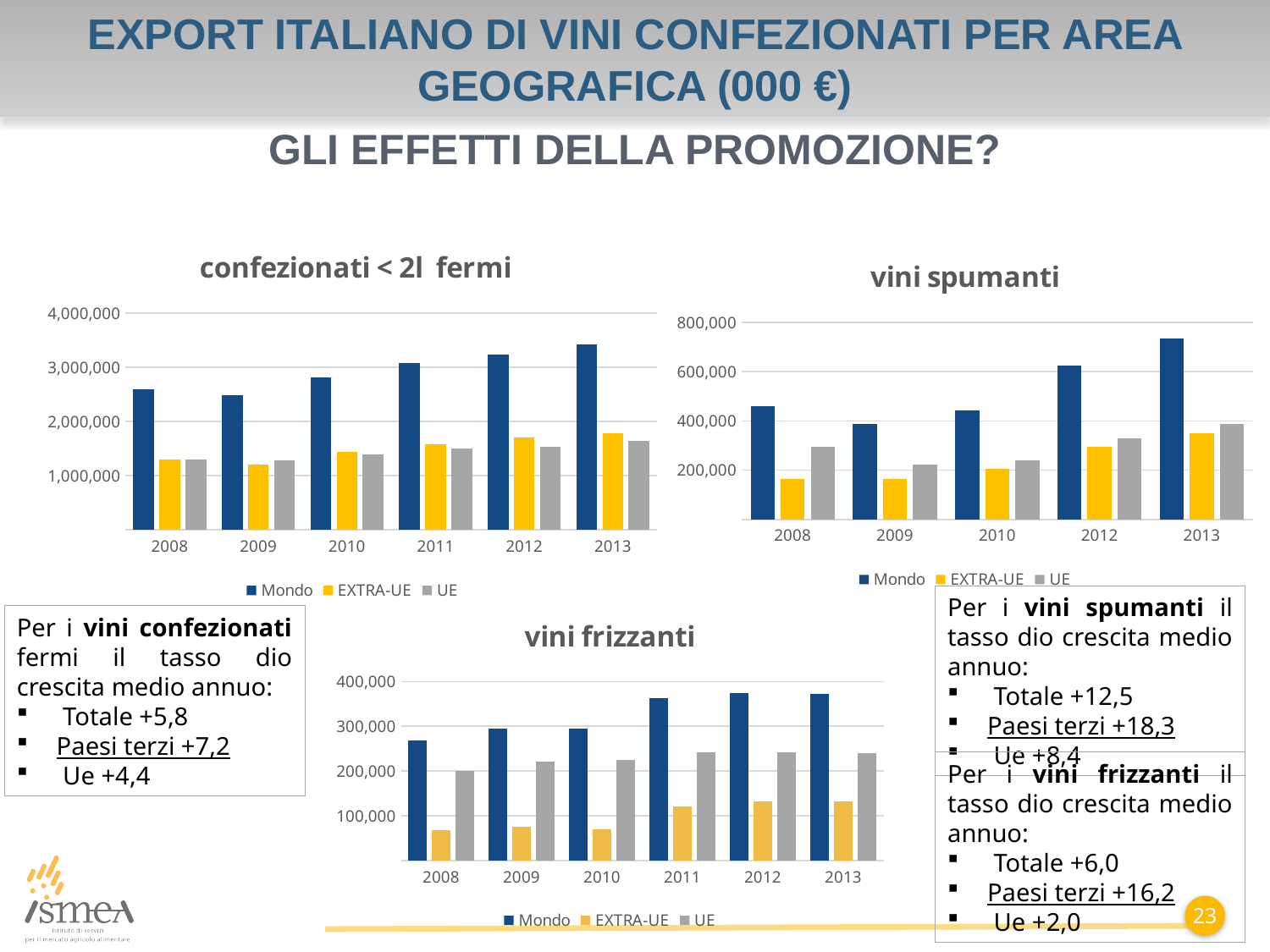
In the 'vini frizzanti' chart, which is larger in 2011: the UE value or the EXTRA-UE value? UE In the 'confezionati < 2l fermi' chart, is the Mondo value for 2013 greater or less than 3,000,000? greater What kind of chart is the 'confezionati < 2l fermi' chart? bar chart Which series is shown in yellow in the 'vini frizzanti' chart? EXTRA-UE How many years are shown on the x axis of the 'vini frizzanti' chart? 6 How many years are shown on the x axis of the 'vini spumanti' chart? 5 In the 'vini spumanti' chart, in which year is the Mondo value highest? 2013 In the 'confezionati < 2l fermi' chart, does the Mondo series generally rise or fall from 2008 to 2013? rise In the 'vini spumanti' chart, is the Mondo value for 2013 greater or less than 600,000? greater How many series does the legend of the 'vini spumanti' chart list? 3 In the 'confezionati < 2l fermi' chart, in which year is the Mondo value highest? 2013 In the 'vini frizzanti' chart, is the EXTRA-UE value for 2008 greater or less than 100,000? less